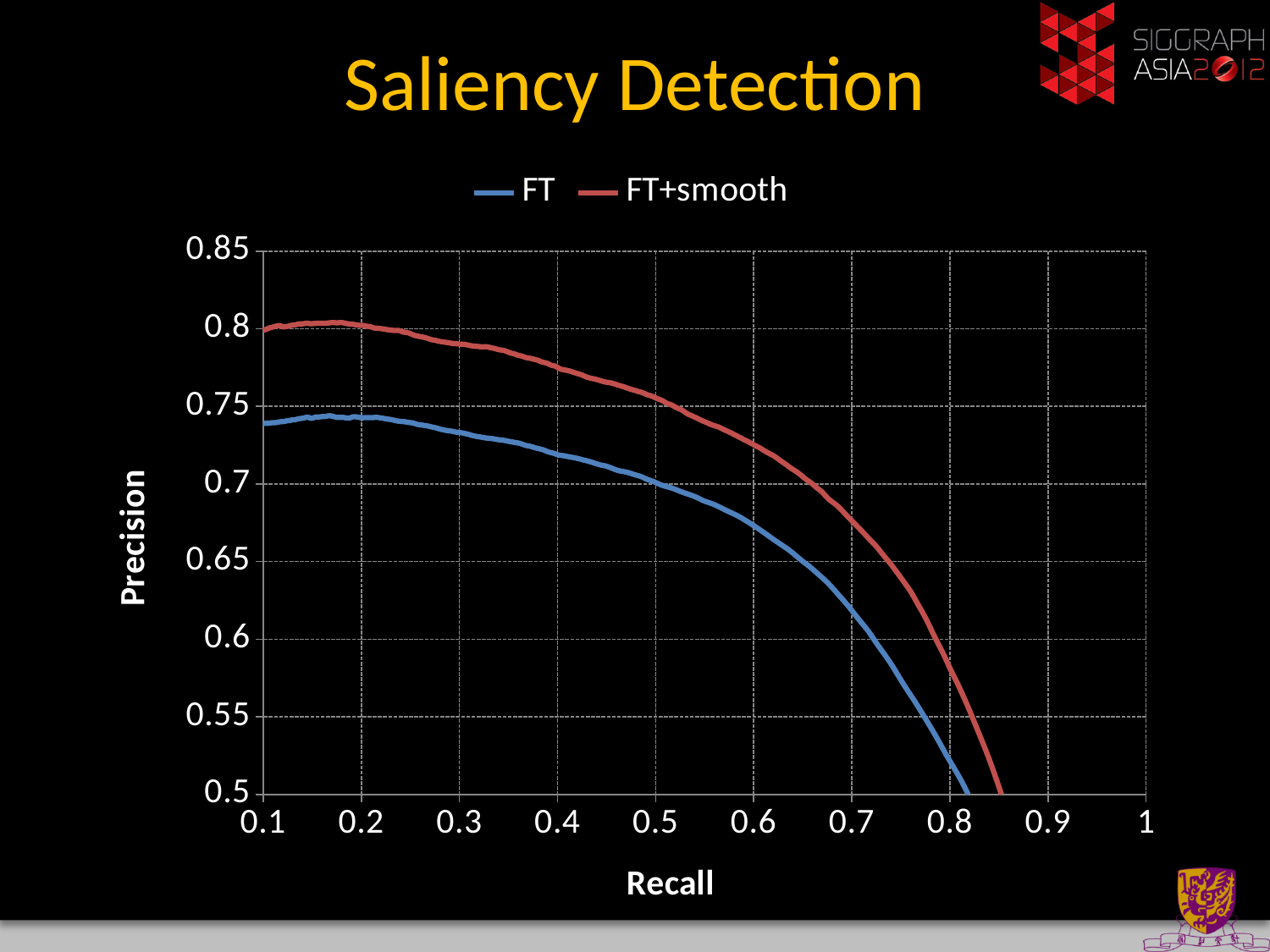
Does the precision of the FT+smooth series rise or fall as recall increases from 0.4 to 0.8? fall Is the precision of FT at a recall of 0.6 greater or less than 0.7? less What are the two series named in the legend? FT and FT+smooth Is the precision of FT+smooth at a recall of 0.3 greater or less than 0.75? greater What is the label of the x axis? Recall Does the precision of the FT series rise or fall as recall increases from 0.3 to 0.8? fall What kind of chart is shown on the slide? line chart Is the precision of FT at a recall of 0.3 greater or less than 0.75? less How many series does the legend list? 2 Which series has the lower precision at a recall of 0.7? FT Which series has the higher precision at a recall of 0.5? FT+smooth